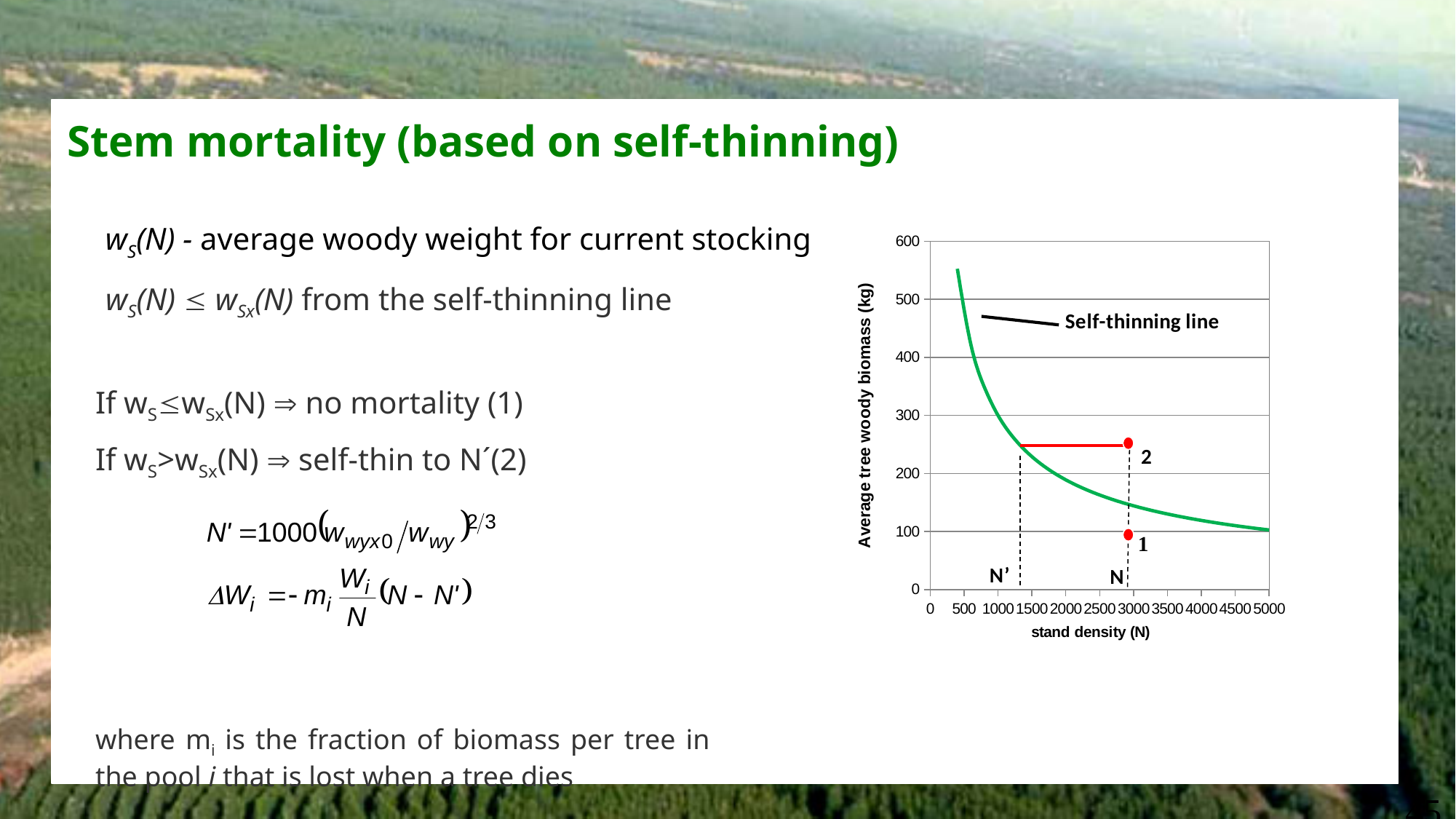
Is the average tree woody biomass at point 2 greater or less than 200? greater Does the green curve rise or fall as stand density increases? fall Which numbered point has the higher average tree woody biomass, point 1 or point 2? 2 Is the value of the green curve at a stand density of 5000 greater or less than 200? less Is the value of the green curve at a stand density of 500 greater or less than 400? greater How many numbered points are marked on the chart? 2 What is the label of the y axis of the chart? Average tree woody biomass (kg) What is the label of the x axis of the chart? stand density (N) What is the highest value shown on the y axis of the chart? 600 What kind of chart is shown on the slide? line chart